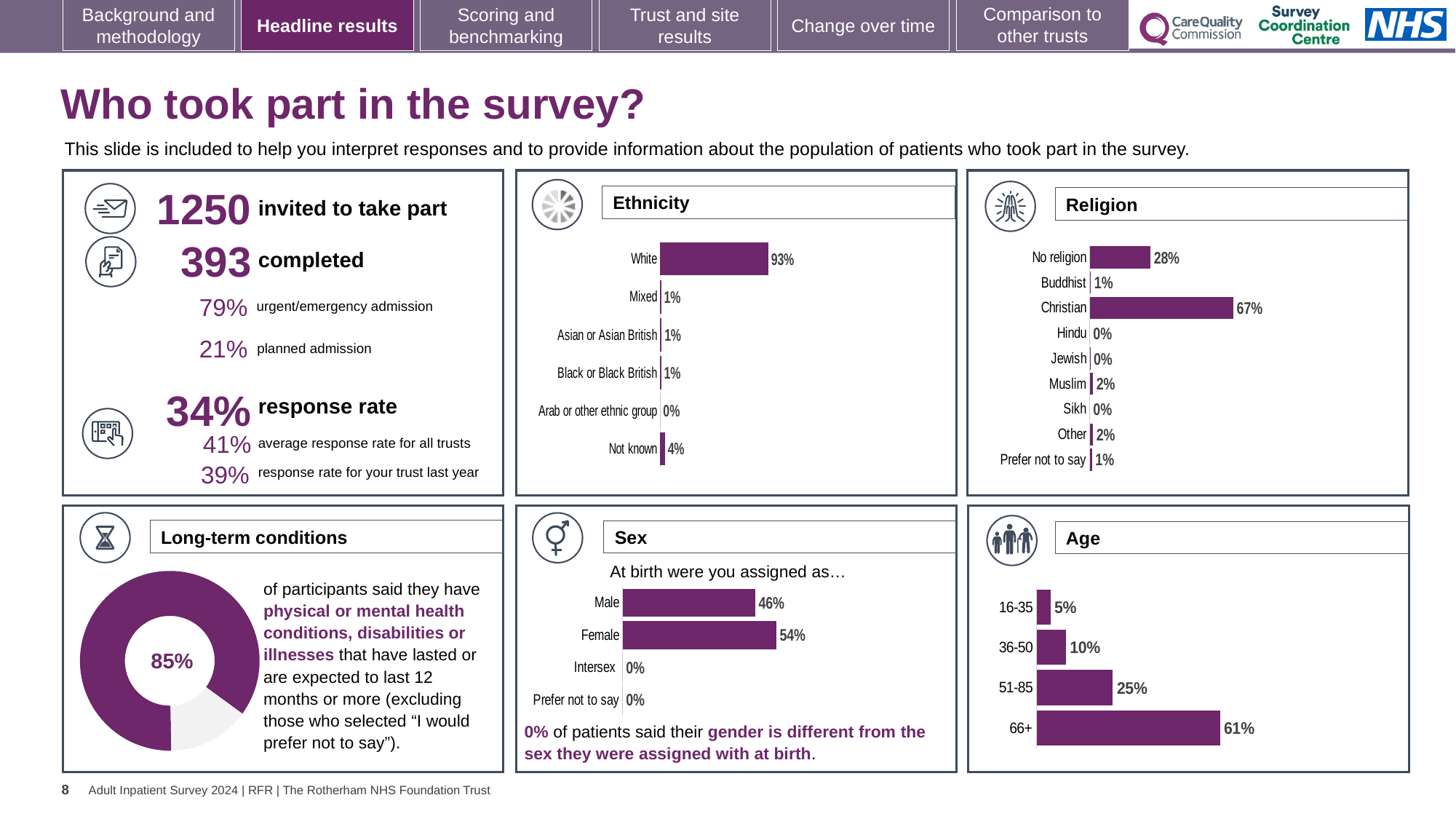
In the Religion chart, what is the difference between Christian and No religion? 39% In the Age chart, what is the value for 51-85? 25% In the Sex chart, which is larger, Male or Female? Female In the Religion chart, what is the value for No religion? 28% In the Religion chart, how many categories are shown? 9 In the Sex chart, what is the difference between Female and Male? 8% In the Religion chart, which category has the highest value? Christian In the Age chart, do the values rise or fall as you go from 16-35 to 66+? rise In the Age chart, which age group has the lowest value? 16-35 In the Ethnicity chart, what percentage of respondents were recorded as Not known? 4% What kind of chart is used in the Long-term conditions panel? doughnut chart In the Ethnicity chart, what percentage of respondents were White? 93%